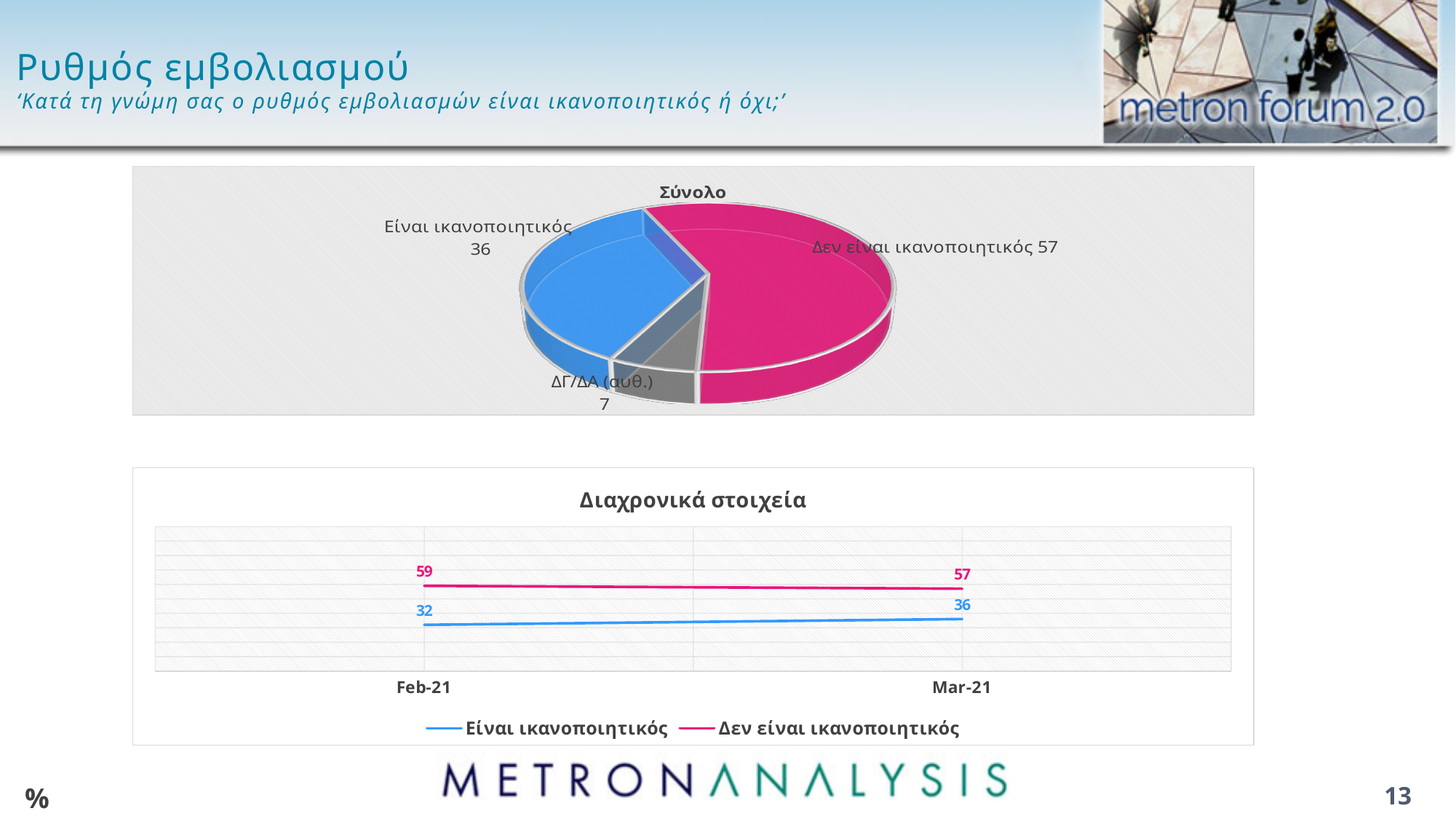
In the chart titled 'Διαχρονικά στοιχεία', what is the value for 'Δεν είναι ικανοποιητικός' in Feb-21? 59 In the pie chart titled 'Σύνολο', which category has the largest slice? Δεν είναι ικανοποιητικός In the pie chart titled 'Σύνολο', which category has the smallest slice? ΔΓ/ΔΑ (αυθ.) In the pie chart titled 'Σύνολο', what is the value for 'Είναι ικανοποιητικός'? 36 In the pie chart titled 'Σύνολο', what is the difference between 'Δεν είναι ικανοποιητικός' and 'Είναι ικανοποιητικός'? 21 In the pie chart titled 'Σύνολο', what is the value for 'Δεν είναι ικανοποιητικός'? 57 In the chart titled 'Διαχρονικά στοιχεία', how many series does the legend list? 2 In the pie chart titled 'Σύνολο', how many slices are there? 3 In the chart titled 'Διαχρονικά στοιχεία', what is the value for 'Είναι ικανοποιητικός' in Mar-21? 36 In the chart titled 'Διαχρονικά στοιχεία', does the 'Είναι ικανοποιητικός' series rise or fall from Feb-21 to Mar-21? rise What kind of chart is the chart titled 'Διαχρονικά στοιχεία'? line chart In the pie chart titled 'Σύνολο', what is the value for 'ΔΓ/ΔΑ (αυθ.)'? 7